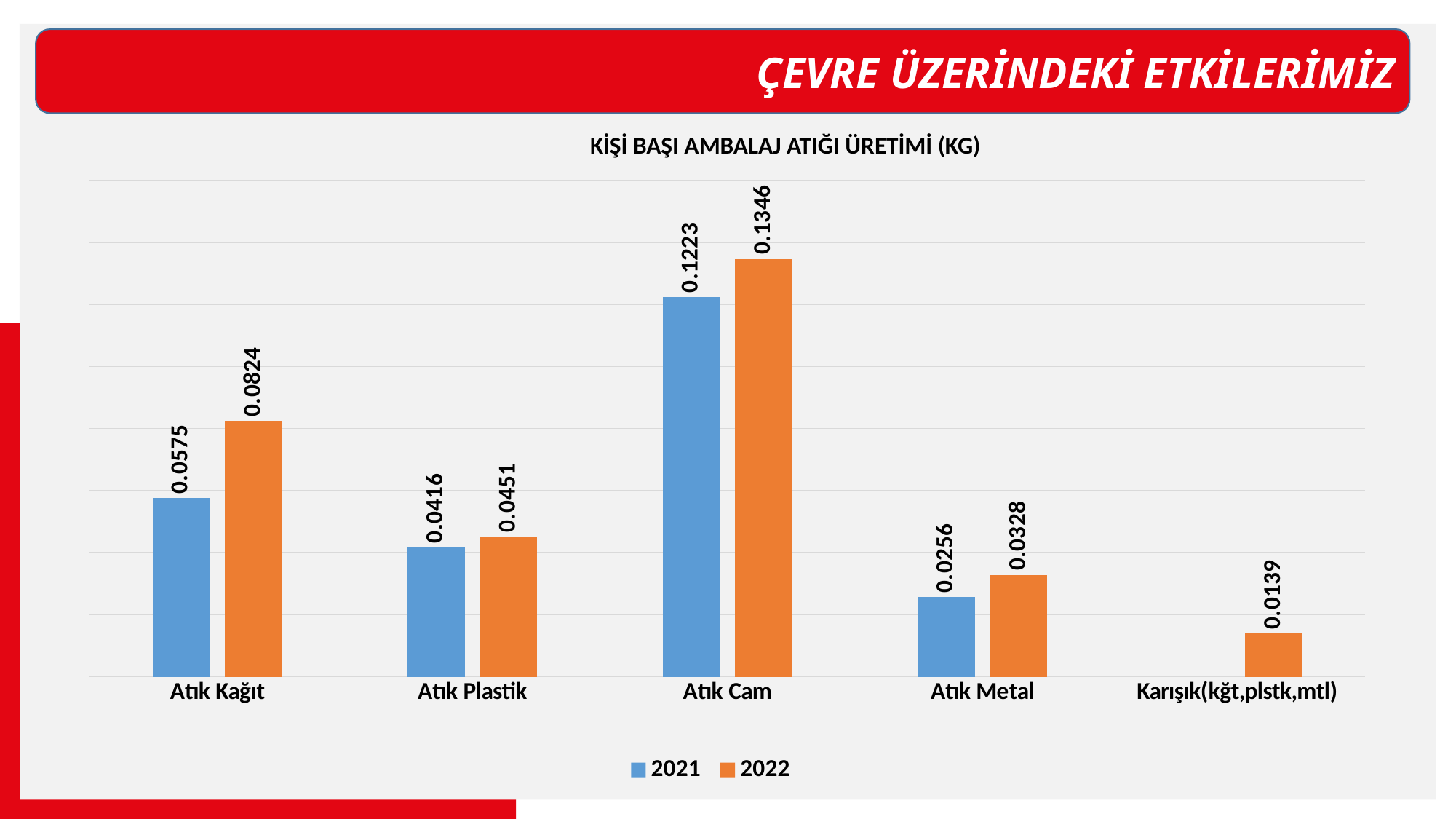
Which category has the lowest 2021 value? Atık Metal What kind of chart is shown on the slide? Bar chart What is the 2021 value for Atık Kağıt? 0.0575 What is the 2022 value for Atık Cam? 0.1346 How many series does the legend list? 2 Which is larger for Atık Plastik, the 2021 value or the 2022 value? 2022 What is the 2022 value for Karışık(kğt,plstk,mtl)? 0.0139 Which category has the highest 2022 value? Atık Cam What is the 2021 value for Atık Metal? 0.0256 What is the difference between the 2022 and 2021 values for Atık Cam? 0.0123 How many categories are shown on the x axis? 5 What is the difference between the 2022 and 2021 values for Atık Kağıt? 0.0249